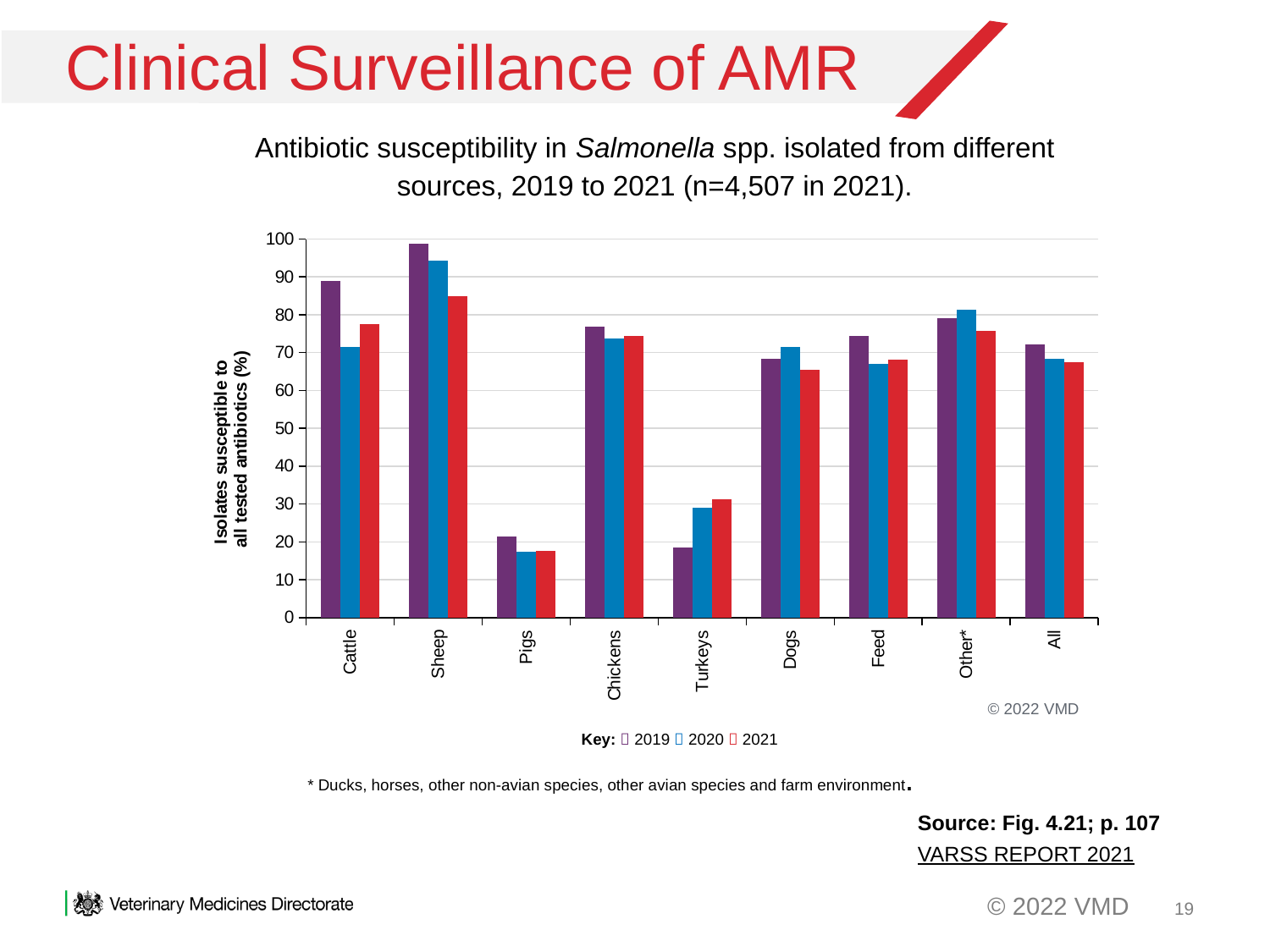
Do the values for Sheep rise or fall from 2019 to 2021? fall Is the 2019 value for Cattle greater or less than 80? greater How many source categories are shown along the x axis? 9 What is the label on the y axis? Isolates susceptible to all tested antibiotics (%) Which source has the lowest percentage of susceptible isolates in 2021? Pigs Is the 2021 value for Turkeys greater or less than 40? less Which source has the highest percentage of susceptible isolates in 2019? Sheep Which has the larger 2019 value, Sheep or Cattle? Sheep How many series does the key list? 3 What kind of chart is shown on the slide? bar chart Is the 2020 value for Pigs greater or less than 20? less For Turkeys, which year has the larger value, 2019 or 2021? 2021